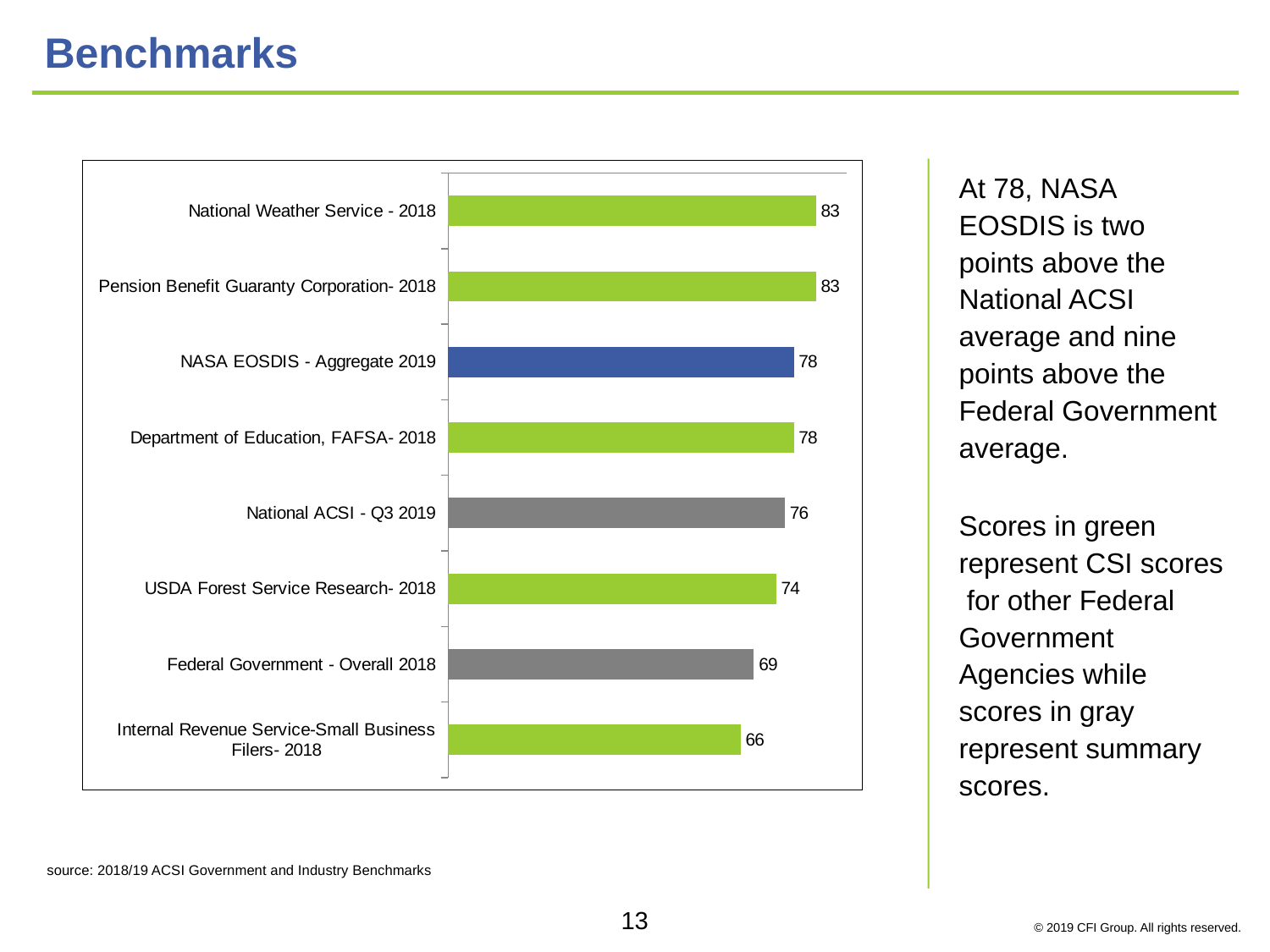
How many categories are shown in the chart? 8 Which category has the lowest value? Internal Revenue Service-Small Business Filers- 2018 What value is shown for both National Weather Service - 2018 and Pension Benefit Guaranty Corporation- 2018? 83 What colour is the bar for NASA EOSDIS - Aggregate 2019? Blue What is the value for Federal Government - Overall 2018? 69 What is the value for National ACSI - Q3 2019? 76 What is the value for USDA Forest Service Research- 2018? 74 What is the value for NASA EOSDIS - Aggregate 2019? 78 What is the difference between the values for NASA EOSDIS - Aggregate 2019 and Federal Government - Overall 2018? 9 Which is larger, the value for USDA Forest Service Research- 2018 or the value for Federal Government - Overall 2018? USDA Forest Service Research- 2018 What kind of chart is shown on the slide? Bar chart What is the difference between the values for National Weather Service - 2018 and National ACSI - Q3 2019? 7